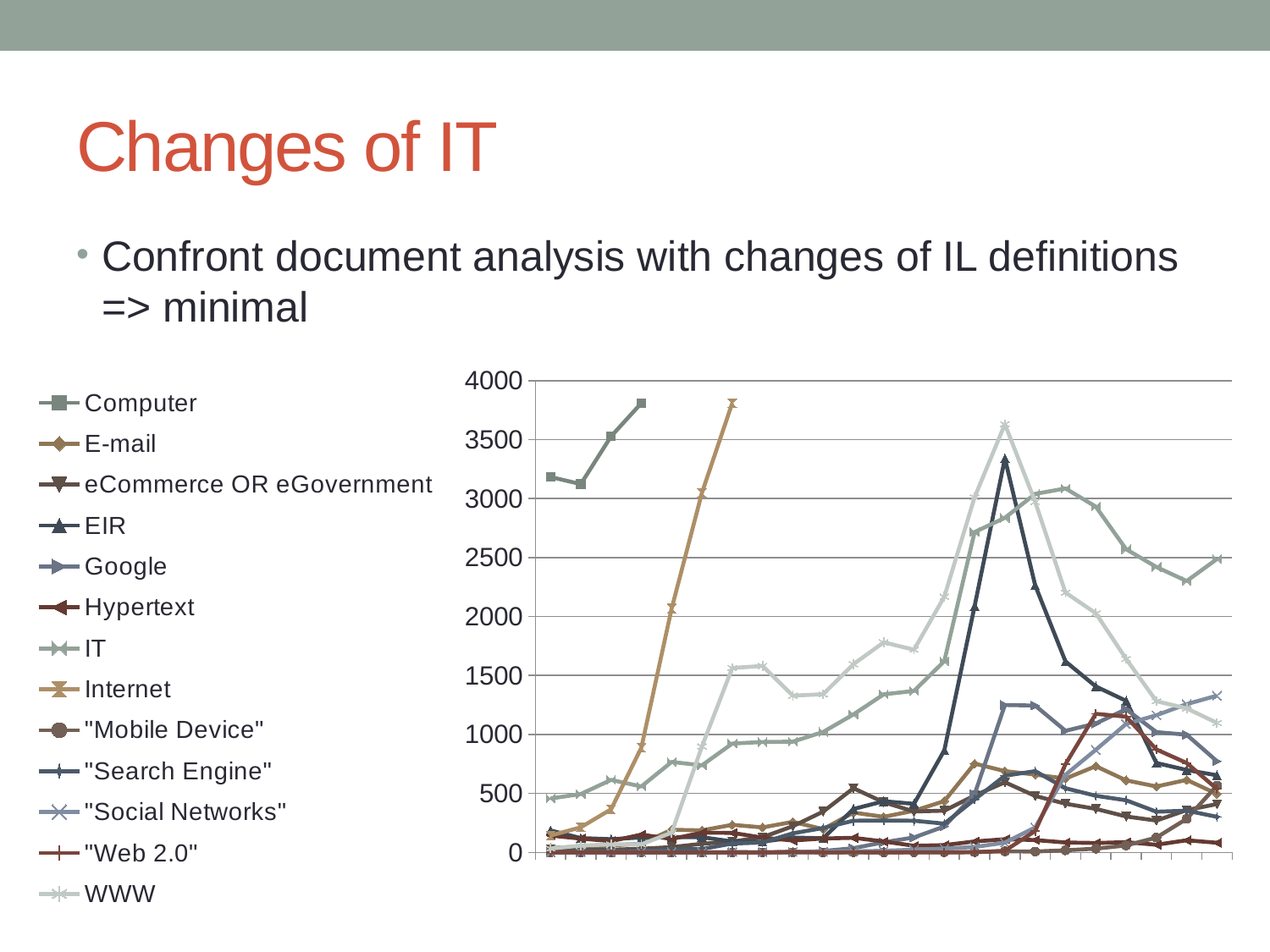
Which series is listed first in the chart's legend? Computer Is the highest value of the WWW series greater or less than 3000? greater Is the highest value of the EIR series greater or less than 3000? greater How many series does the chart's legend list? 13 Is the highest value of the "Mobile Device" series greater or less than 1000? less Do the values of the Internet series rise or fall along the x axis? rise What kind of chart is shown on the slide? line chart Which series is listed last in the chart's legend? WWW Do the values of the Computer series rise or fall along the x axis? rise